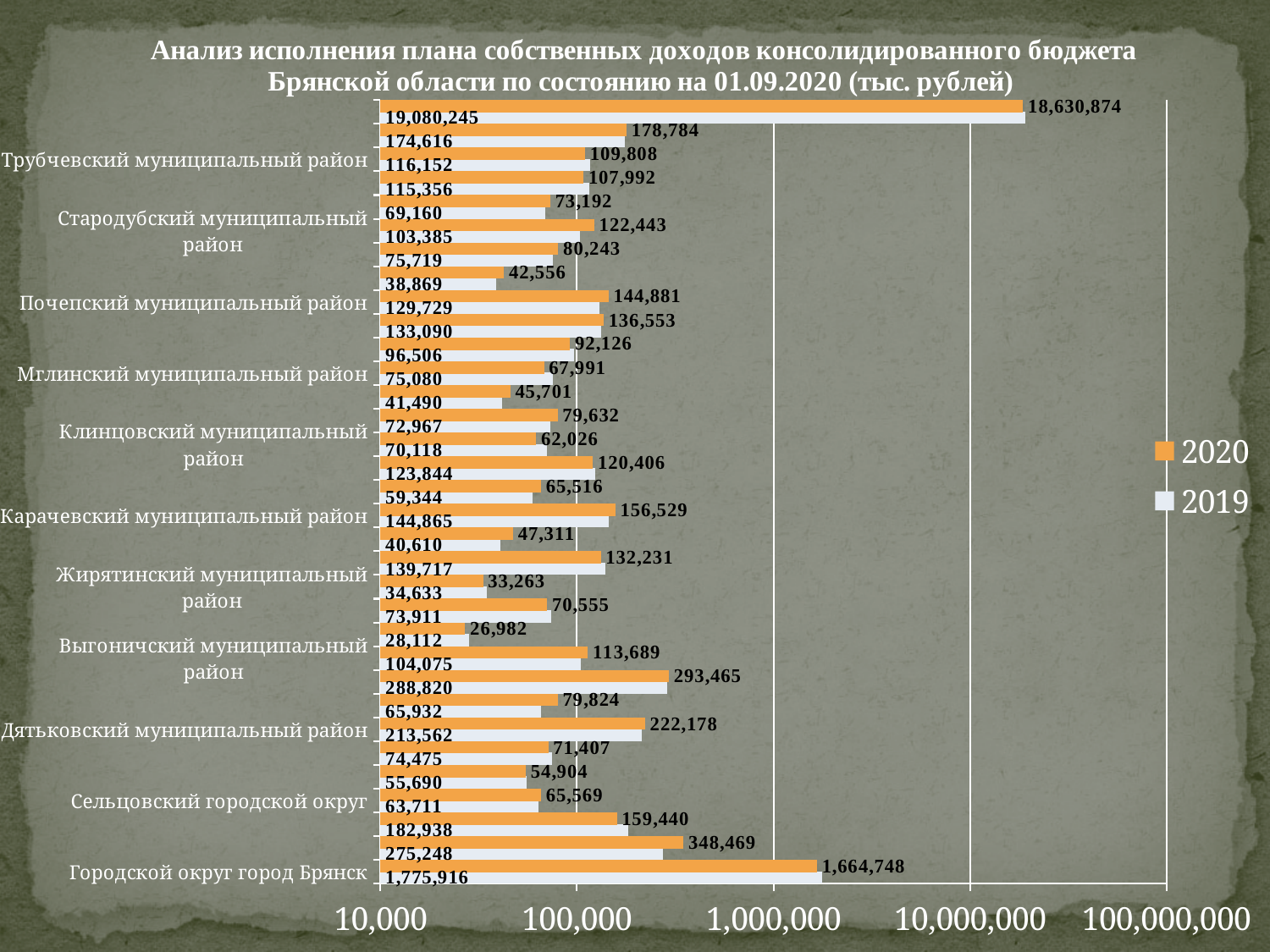
What is the 2020 value for Дятьковский муниципальный район? 222,178 What kind of chart is shown on the slide? bar chart Which colour represents the 2020 series in the legend? orange How many series does the legend list? 2 For Городской округ город Брянск, which year has the larger value, 2019 or 2020? 2019 What is the 2019 value for Городской округ город Брянск? 1,775,916 What is the 2020 value for Городской округ город Брянск? 1,664,748 What is the 2019 value for Карачевский муниципальный район? 144,865 What is the 2020 value for Жирятинский муниципальный район? 33,263 What is the difference between the 2020 and 2019 values for Дятьковский муниципальный район? 8,616 What is the 2020 value for Почепский муниципальный район? 144,881 Is the 2020 value for Мглинский муниципальный район greater or less than 100,000? less